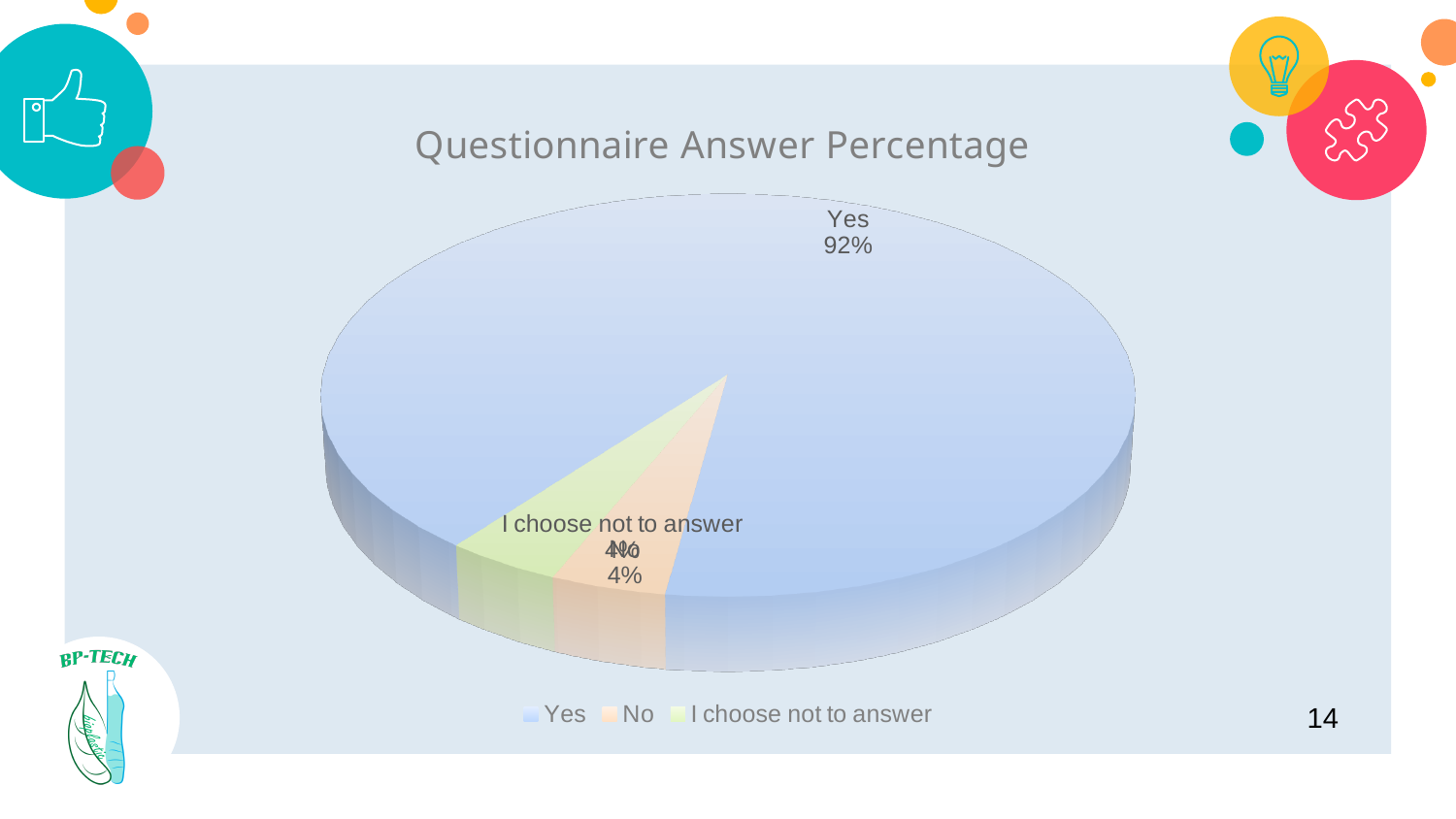
What kind of chart is shown on the slide? pie chart What is the difference in percentage points between the Yes slice and the No slice? 88% What percentage of the pie is the No slice? 4% Which is larger, the Yes slice or the No slice? Yes What share of the pie does the Yes category represent? 92% Which answer category has the largest share of the pie? Yes What is the title of the chart? Questionnaire Answer Percentage What are the three categories listed in the legend? Yes, No, I choose not to answer What percentage of the pie is the 'I choose not to answer' slice? 4% How many entries does the legend list? 3 How many slices does the pie chart have? 3 What percentage of the pie is the Yes slice? 92%